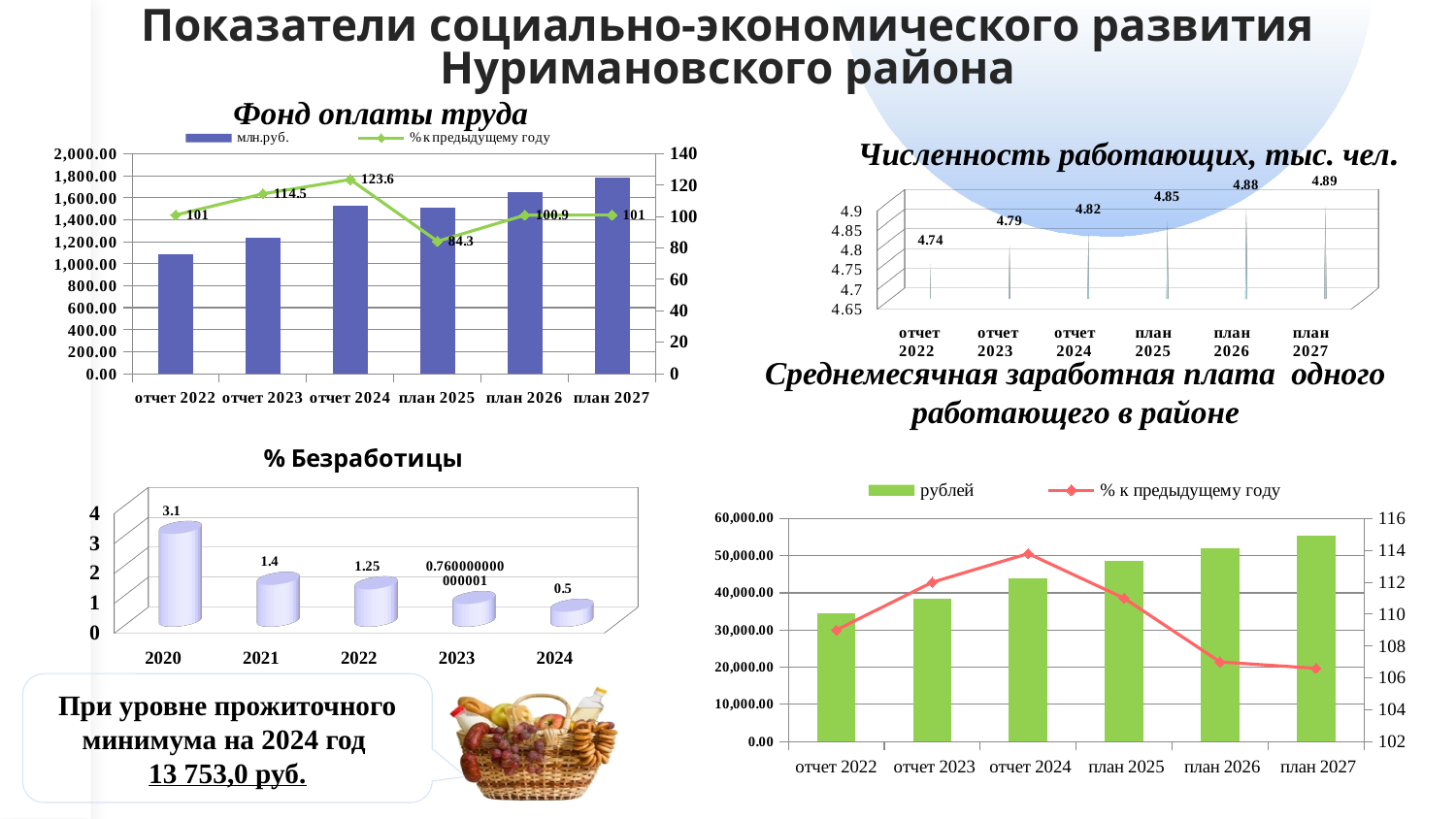
In the '% Безработицы' chart, what is the value for 2020? 3.1 In the 'Численность работающих, тыс. чел.' chart, what is the difference between the values for план 2027 and отчет 2022? 0.15 In the 'Численность работающих, тыс. чел.' chart, do the values rise or fall from отчет 2022 to план 2027? rise In the '% Безработицы' chart, what is the difference between the values for 2020 and 2021? 1.7 In the '% Безработицы' chart, which year has the lowest value? 2024 In the 'Численность работающих, тыс. чел.' chart, what is the value for план 2027? 4.89 In the 'Фонд оплаты труда' chart, is the bar value (млн.руб.) for план 2027 greater or less than 1,600.00? greater In the 'Фонд оплаты труда' chart, what is the value of '% к предыдущему году' for отчет 2024? 123.6 In the 'Среднемесячная заработная плата одного работающего в районе' chart, is the bar value (рублей) for план 2027 greater or less than 50,000.00? greater In the '% Безработицы' chart, how many years are shown on the x axis? 5 In the 'Фонд оплаты труда' chart, how many series does the legend list? 2 In the 'Фонд оплаты труда' chart, which category has the lowest '% к предыдущему году' value? план 2025